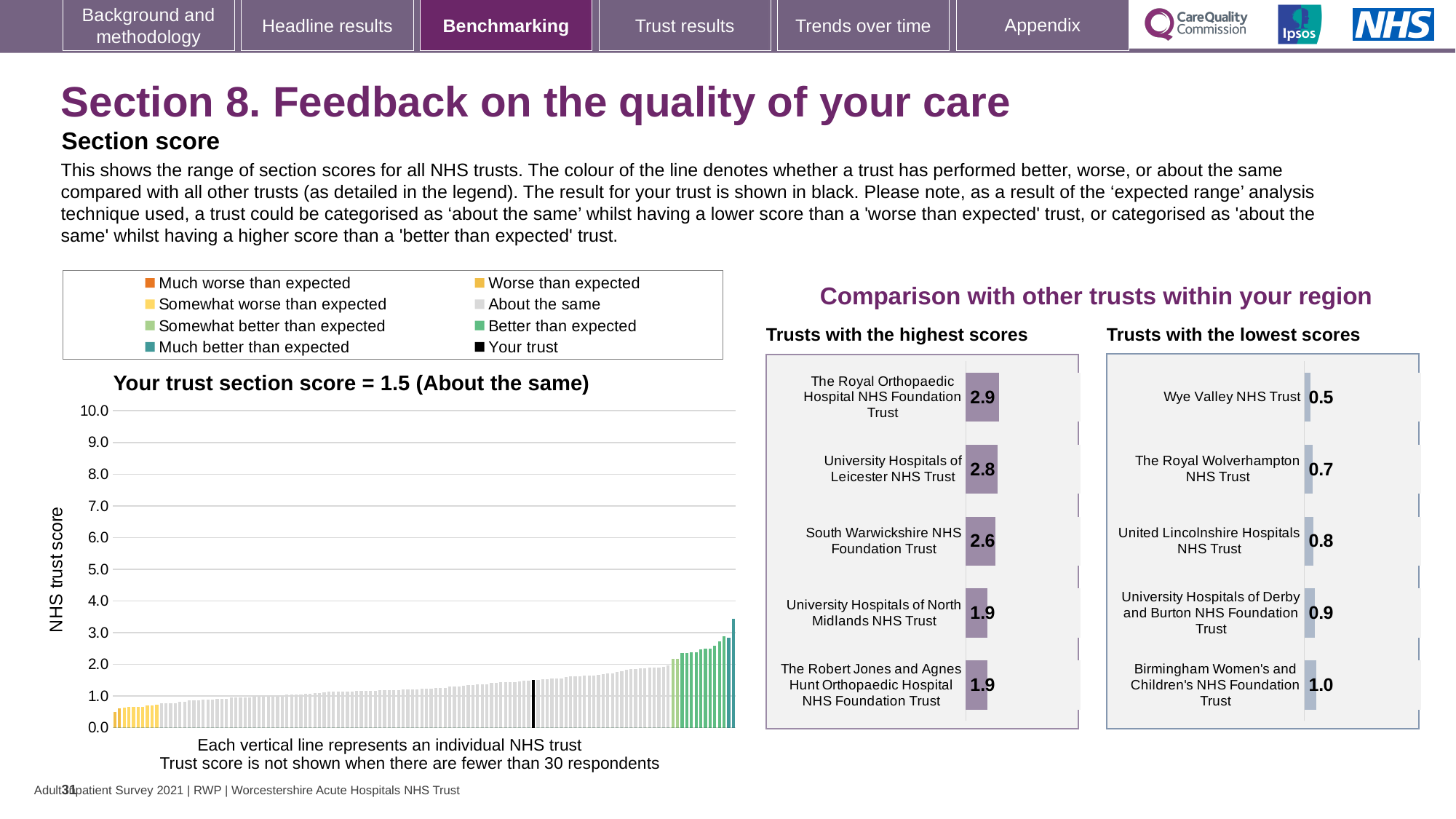
In the 'Your trust section score' chart, is the value of the rightmost (tallest) bar greater or less than 3.0? greater In the 'Trusts with the lowest scores' chart, what is the score for Wye Valley NHS Trust? 0.5 According to the title of the left-hand chart, what is your trust's section score? 1.5 In the 'Trusts with the highest scores' chart, which trust has the highest score? The Royal Orthopaedic Hospital NHS Foundation Trust How many trusts are shown in the 'Trusts with the highest scores' chart? 5 What kind of chart is the 'Your trust section score' chart on the left? Bar chart In the 'Trusts with the lowest scores' chart, what is the difference between the scores of Birmingham Women's and Children's NHS Foundation Trust and Wye Valley NHS Trust? 0.5 In the 'Trusts with the lowest scores' chart, which has the larger score: The Royal Wolverhampton NHS Trust or United Lincolnshire Hospitals NHS Trust? United Lincolnshire Hospitals NHS Trust In the 'Trusts with the highest scores' chart, what is the difference between the scores of The Royal Orthopaedic Hospital NHS Foundation Trust and South Warwickshire NHS Foundation Trust? 0.3 In the 'Trusts with the lowest scores' chart, which trust has the lowest score? Wye Valley NHS Trust In the 'Trusts with the highest scores' chart, what is the score for The Royal Orthopaedic Hospital NHS Foundation Trust? 2.9 In the 'Your trust section score' chart, do the bar values rise or fall from left to right along the x axis? Rise